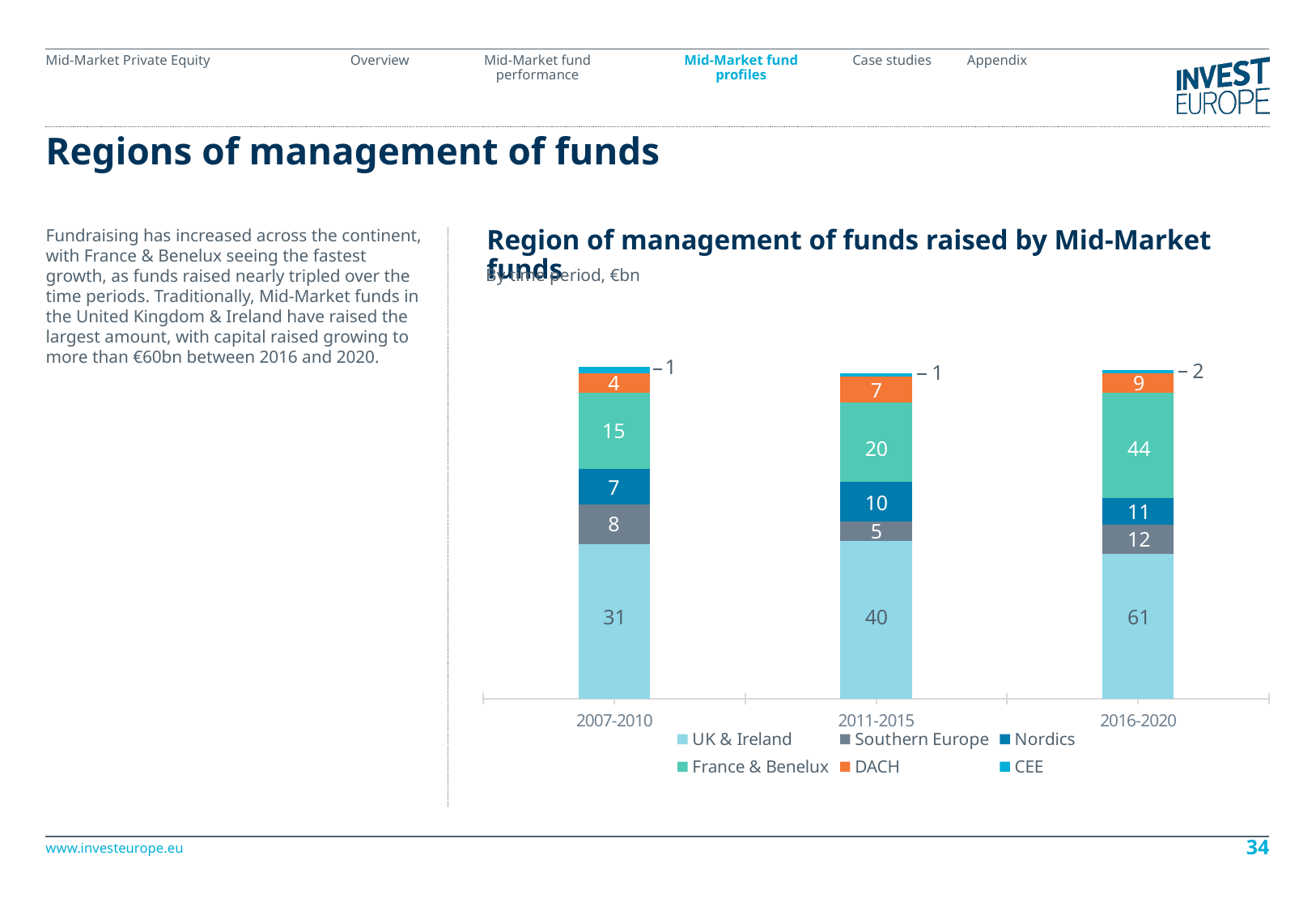
What is the value for France & Benelux in 2011-2015? 20 What is the value for DACH in 2007-2010? 4 What is the value for UK & Ireland in 2016-2020? 61 How many time periods are shown on the x axis? 3 Which time period has the lowest value for Southern Europe? 2011-2015 Does the value for UK & Ireland rise or fall across the time periods from 2007-2010 to 2016-2020? Rise What is the value for CEE in 2016-2020? 2 What is the total of the stacked bar for 2016-2020? 139 How many series does the legend list? 6 Which time period has the highest value for France & Benelux? 2016-2020 What type of chart is shown on the slide? Stacked bar chart What is the difference between the UK & Ireland values for 2016-2020 and 2007-2010? 30